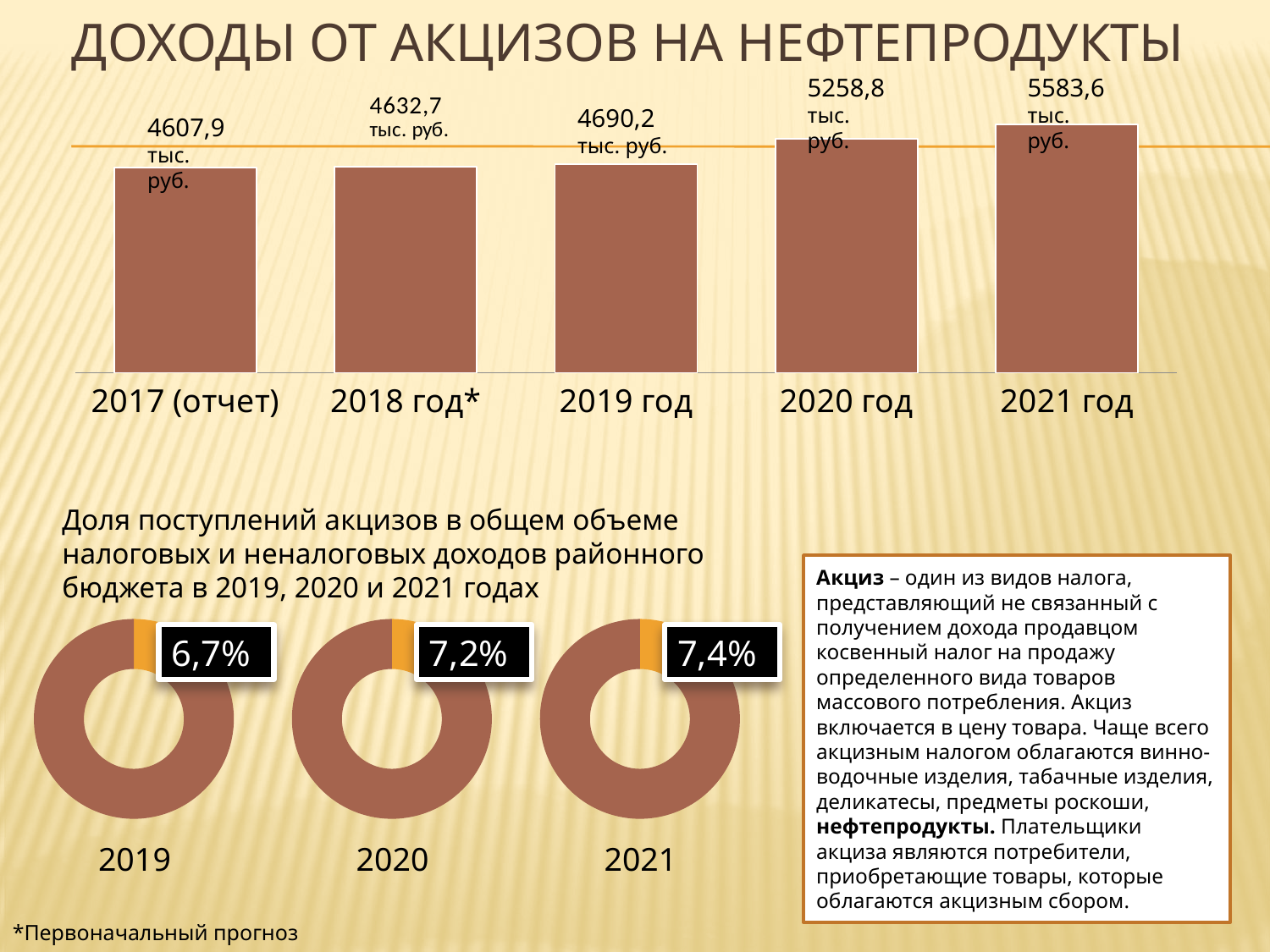
In the bar chart 'ДОХОДЫ ОТ АКЦИЗОВ НА НЕФТЕПРОДУКТЫ', do the values rise or fall from 2017 to 2021? Rise What type of chart is the top chart 'ДОХОДЫ ОТ АКЦИЗОВ НА НЕФТЕПРОДУКТЫ'? Bar chart In the bar chart 'ДОХОДЫ ОТ АКЦИЗОВ НА НЕФТЕПРОДУКТЫ', what is the difference between the values for 2020 год and 2019 год? 568,6 тыс. руб. In the bar chart 'ДОХОДЫ ОТ АКЦИЗОВ НА НЕФТЕПРОДУКТЫ', which category has the lowest value? 2017 (отчет) In the donut charts at the bottom left, what share is shown for 2019? 6,7% How many bars are in the bar chart 'ДОХОДЫ ОТ АКЦИЗОВ НА НЕФТЕПРОДУКТЫ'? 5 In the bar chart 'ДОХОДЫ ОТ АКЦИЗОВ НА НЕФТЕПРОДУКТЫ', what is the difference between the values for 2021 год and 2017 (отчет)? 975,7 тыс. руб. In the bar chart 'ДОХОДЫ ОТ АКЦИЗОВ НА НЕФТЕПРОДУКТЫ', which year has the highest value? 2021 год In the bar chart 'ДОХОДЫ ОТ АКЦИЗОВ НА НЕФТЕПРОДУКТЫ', which is larger: the value for 2018 год* or the value for 2020 год? 2020 год In the bar chart 'ДОХОДЫ ОТ АКЦИЗОВ НА НЕФТЕПРОДУКТЫ', what is the value for 2020 год? 5258,8 тыс. руб. In the bar chart 'ДОХОДЫ ОТ АКЦИЗОВ НА НЕФТЕПРОДУКТЫ', what is the value for 2017 (отчет)? 4607,9 тыс. руб. In the donut charts at the bottom left, what share is shown for 2021? 7,4%